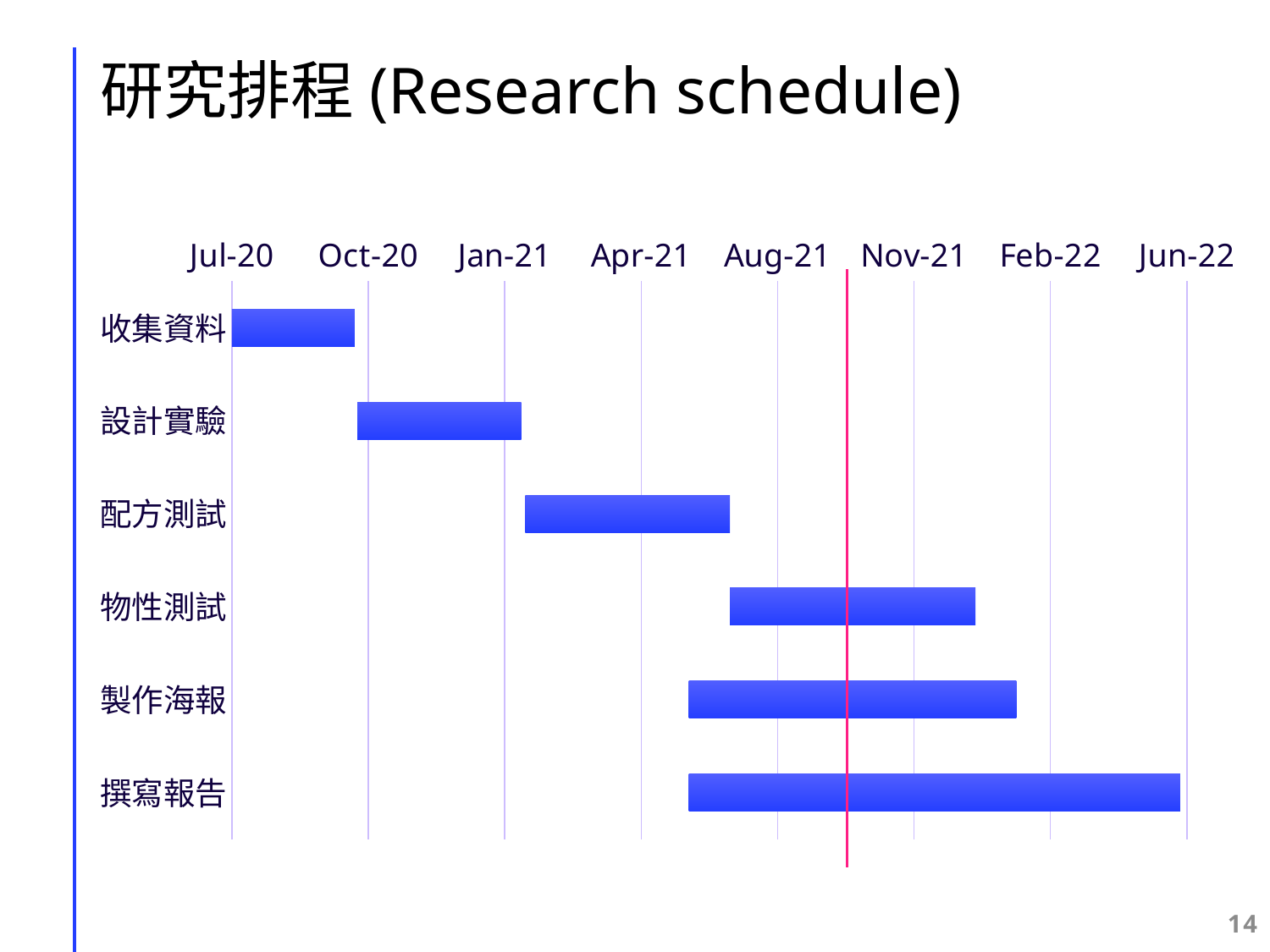
Does the bar for 撰寫報告 extend past Feb-22? yes Which task starts first on the timeline? 收集資料 What is the title of the slide containing the chart? 研究排程 (Research schedule) Does the bar for 收集資料 end before or after Oct-20? before Which task ends last on the timeline? 撰寫報告 Which bar is longer, 設計實驗 or 物性測試? 物性測試 Which task has the shortest bar on the chart? 收集資料 Does the bar for 配方測試 start before or after Jan-21? after Which task has the longest bar on the chart? 撰寫報告 How many tasks are listed on the chart? 6 What kind of chart is shown on the slide? bar chart (Gantt chart)